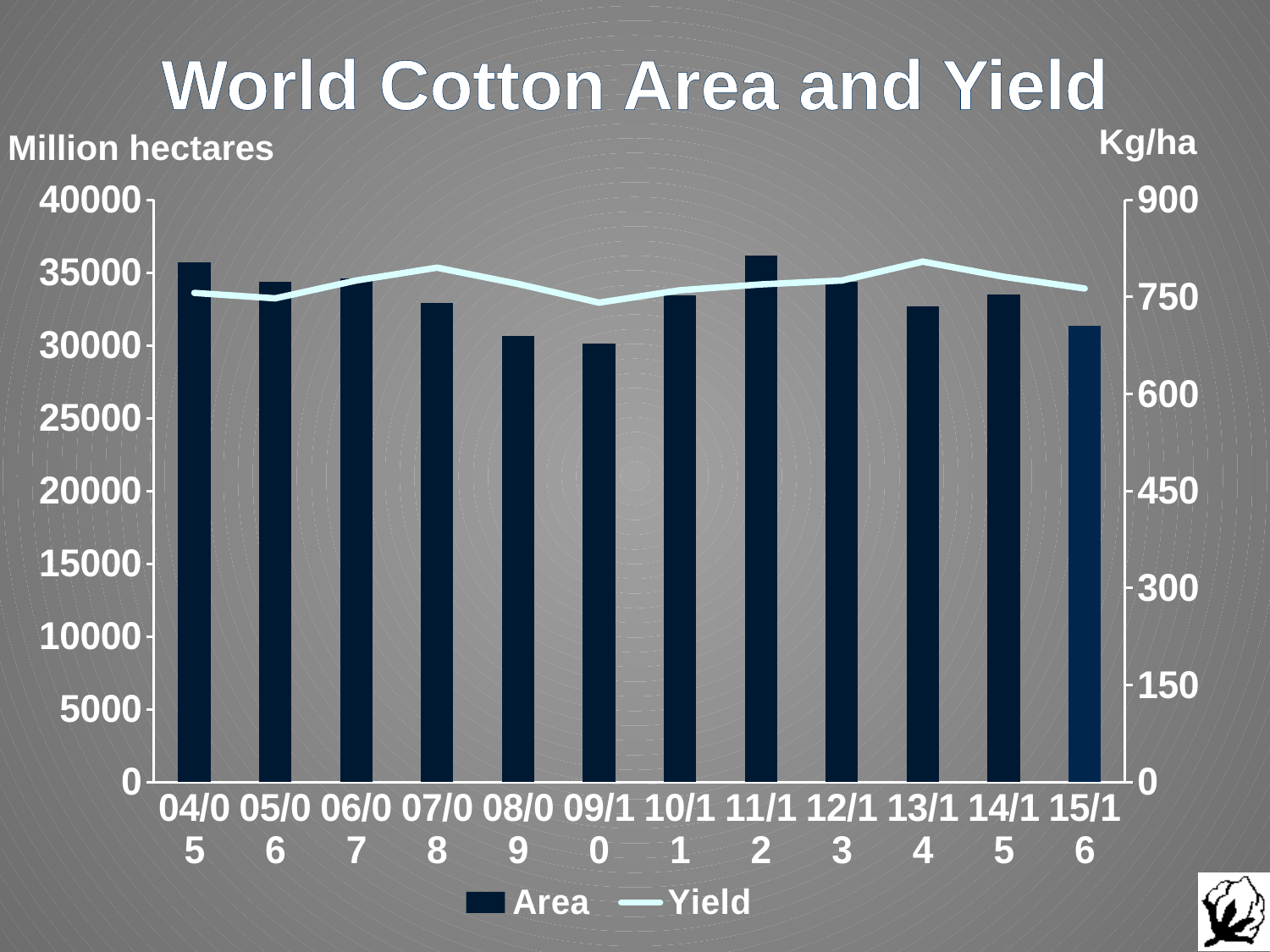
What unit is shown on the right-hand axis for Yield? Kg/ha Is the Yield value for 13/14 greater or less than 750? greater Is the Area value for 09/10 greater or less than 35000? less How many series does the legend list? 2 Is the Area value for 15/16 greater or less than 30000? greater Does the Area series rise or fall from 04/05 to 09/10? fall Which is larger, the Area for 04/05 or the Area for 09/10? 04/05 How many seasons are shown on the x axis? 12 Which season has the highest Area bar? 11/12 What is the title of the chart? World Cotton Area and Yield What kind of chart is this? Combination bar and line chart